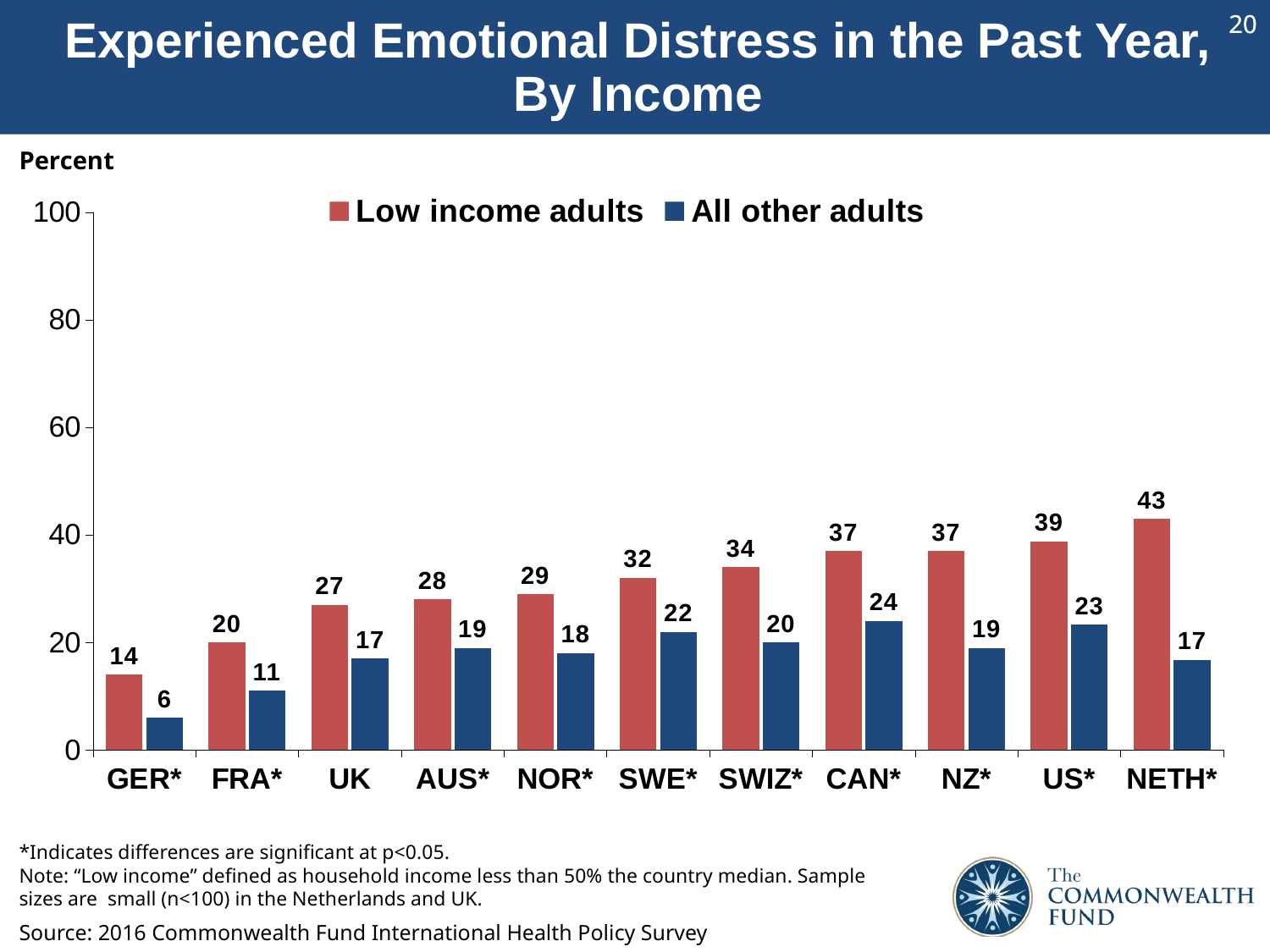
What is the value for All other adults in GER*? 6 Which is larger in the US*: Low income adults or All other adults? Low income adults Is the value for Low income adults in SWE* greater or less than 40? less How many countries are shown on the x axis? 11 What is the value for All other adults in CAN*? 24 What is the difference between Low income adults and All other adults in NETH*? 26 What is the value for Low income adults in NETH*? 43 Which country has the lowest value for All other adults? GER* What colour are the bars for Low income adults? red How many series does the legend list? 2 What kind of chart is shown on the slide? bar chart Which country has the highest value for Low income adults? NETH*